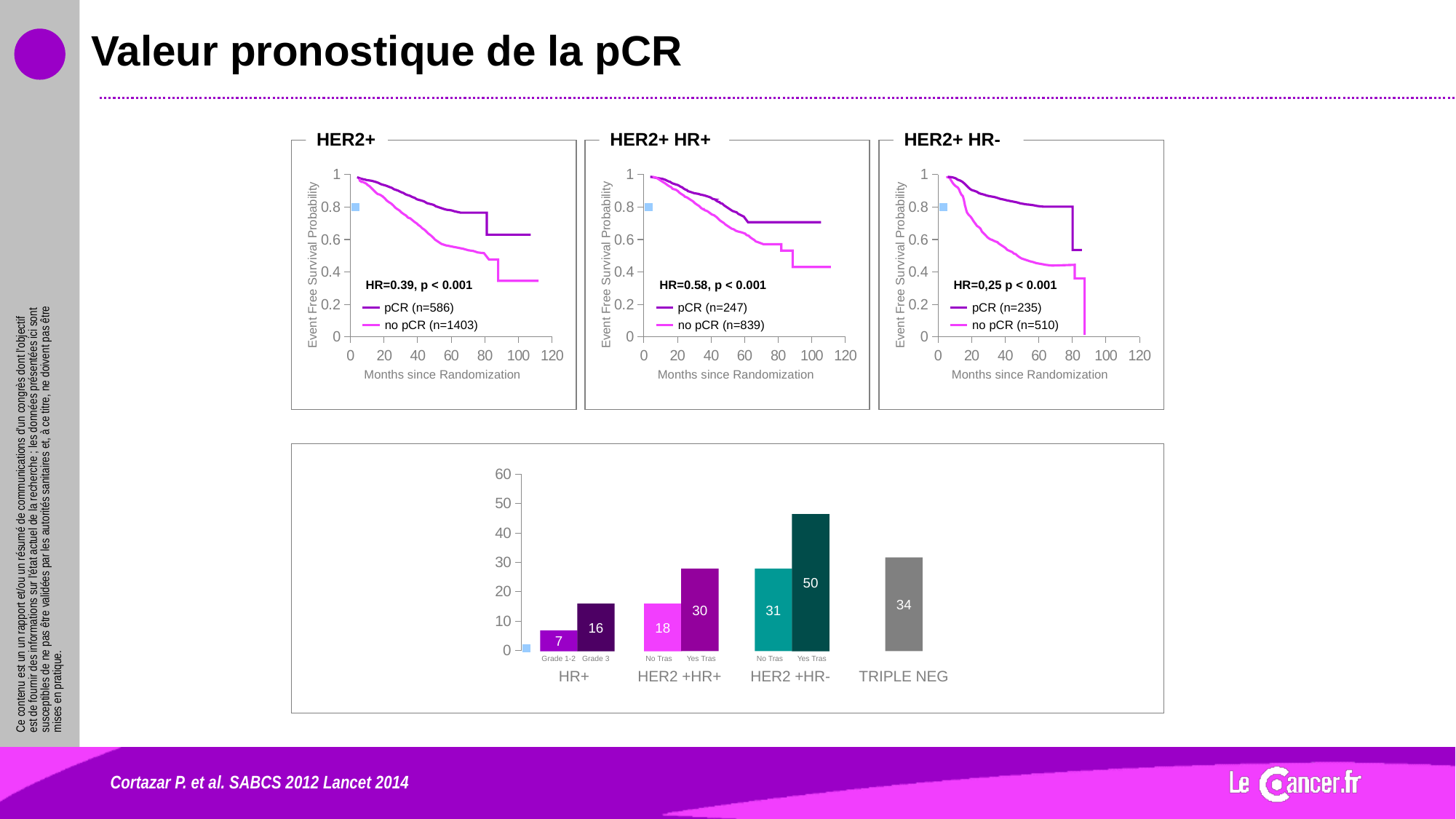
In the bottom bar chart, what is the difference between Yes Tras and No Tras in the HER2 +HR+ group? 12 In the bottom bar chart, what is the value for Yes Tras in the HER2 +HR- group? 50 In the bottom bar chart, what is the value for TRIPLE NEG? 34 In the bottom bar chart, what is the value for Grade 3 in the HR+ group? 16 In the bottom bar chart, which bar has the highest value? Yes Tras in HER2 +HR- In the HER2+ HR- chart, is the pCR curve at 60 months greater or less than 0.6? greater In the bottom bar chart, which is larger: TRIPLE NEG or Yes Tras in HER2 +HR+? TRIPLE NEG In the HER2+ chart, how many series does the legend list? 2 How many bars are plotted in the bottom bar chart? 7 What kind of chart is the chart at the bottom of the slide? bar chart In the HER2+ chart, what is the n for the no pCR legend entry? 1403 In the bottom bar chart, which bar has the lowest value? Grade 1-2 in HR+